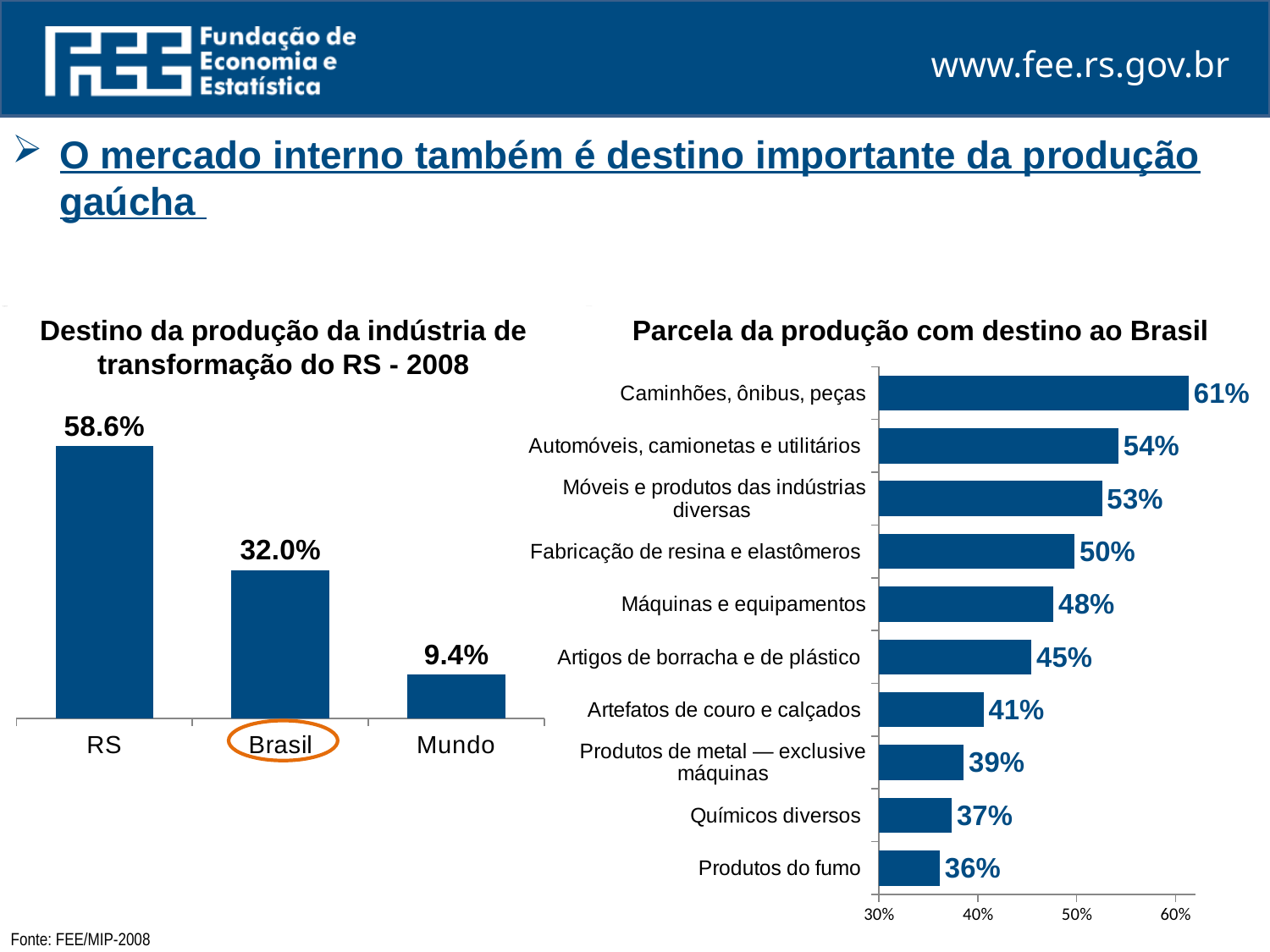
In the chart 'Destino da produção da indústria de transformação do RS - 2008', which category is circled in orange? Brasil What kind of chart is 'Parcela da produção com destino ao Brasil'? Bar chart In the chart 'Destino da produção da indústria de transformação do RS - 2008', how many categories are shown? 3 In the chart 'Parcela da produção com destino ao Brasil', which is larger: Artefatos de couro e calçados or Fabricação de resina e elastômeros? Fabricação de resina e elastômeros In the chart 'Parcela da produção com destino ao Brasil', which category has the lowest value? Produtos do fumo In the chart 'Parcela da produção com destino ao Brasil', how many categories are shown? 10 In the chart 'Parcela da produção com destino ao Brasil', which category has the highest value? Caminhões, ônibus, peças In the chart 'Destino da produção da indústria de transformação do RS - 2008', what is the value for Brasil? 32.0% In the chart 'Parcela da produção com destino ao Brasil', what is the value for Máquinas e equipamentos? 48% In the chart 'Destino da produção da indústria de transformação do RS - 2008', which category has the highest value? RS In the chart 'Parcela da produção com destino ao Brasil', what is the difference between Caminhões, ônibus, peças and Químicos diversos? 24% In the chart 'Destino da produção da indústria de transformação do RS - 2008', what is the difference between the values for RS and Mundo? 49.2%